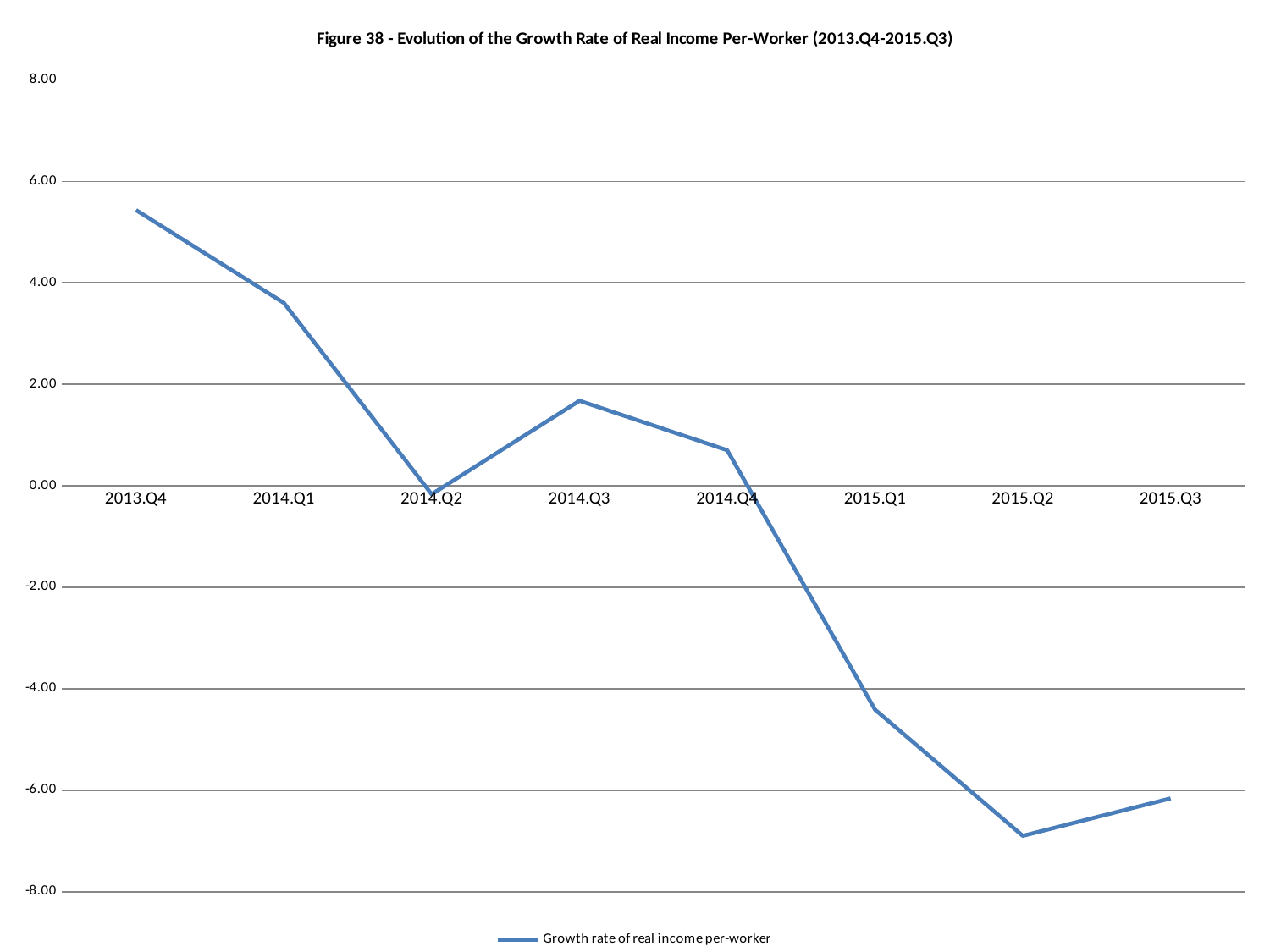
Is the growth rate for 2013.Q4 greater or less than 4.00? greater What type of chart is shown on the slide? line chart Is the growth rate for 2015.Q1 greater or less than -4.00? less How many series does the legend list? 1 Which quarter has the lowest growth rate of real income per-worker? 2015.Q2 Is the growth rate for 2014.Q3 greater or less than 2.00? less Which quarter has the highest growth rate of real income per-worker? 2013.Q4 Which quarter has the larger growth rate, 2014.Q1 or 2014.Q4? 2014.Q1 Does the growth rate generally rise or fall from 2013.Q4 to 2015.Q2? fall How many quarters are plotted on the x axis? 8 What is the title of the chart? Figure 38 - Evolution of the Growth Rate of Real Income Per-Worker (2013.Q4-2015.Q3)